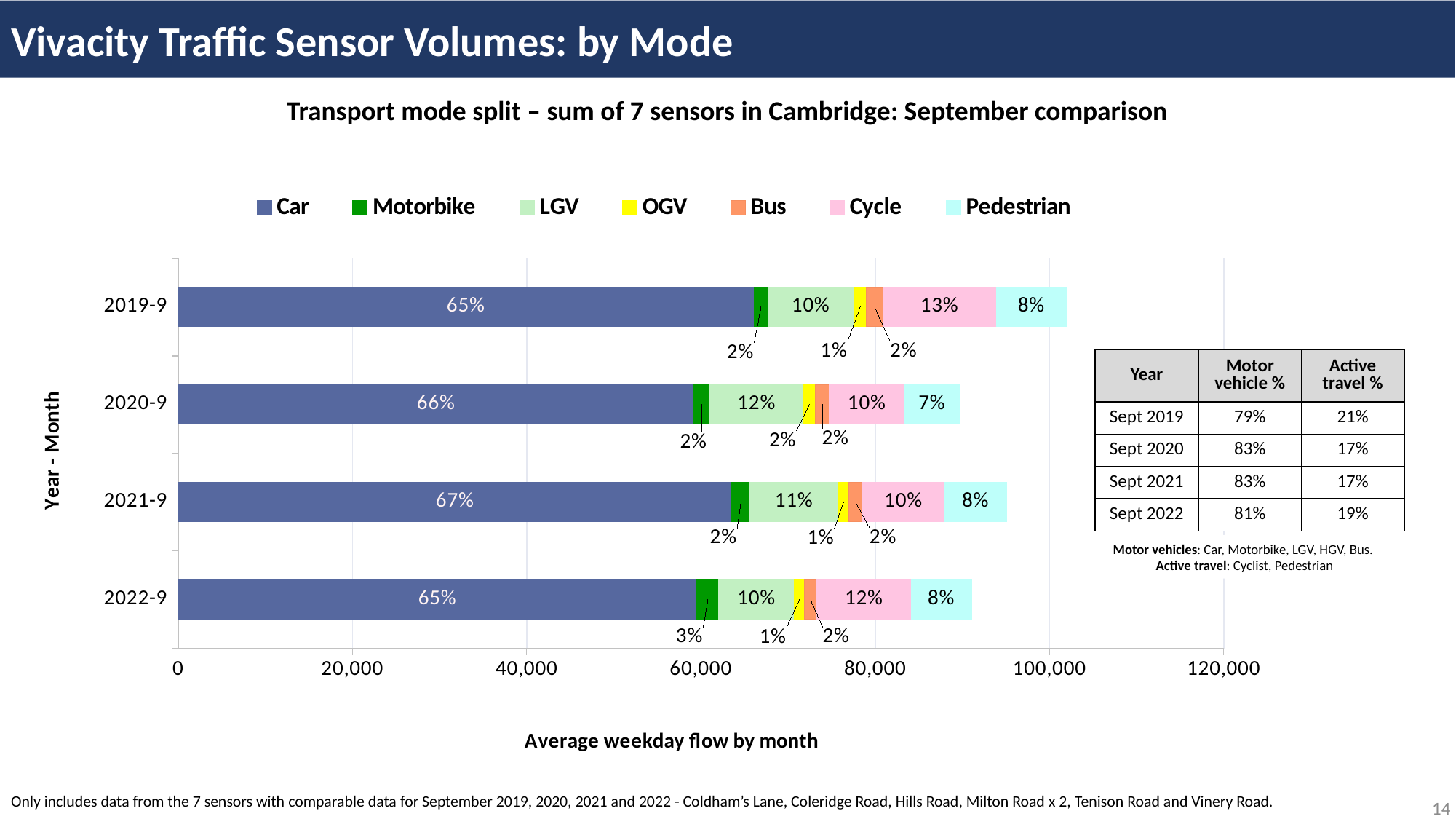
What is the Pedestrian share shown for 2020-9? 7% What type of chart is shown on the slide? Stacked bar chart Which year-month has the highest Car percentage? 2021-9 Which year-month has the lowest Pedestrian percentage? 2020-9 By how many percentage points does the Cycle share in 2019-9 exceed the Cycle share in 2022-9? 1 percentage point How many series does the legend list? 7 What is the Cycle share shown for 2019-9? 13% Which has the larger LGV share, 2019-9 or 2020-9? 2020-9 What is the Motorbike share shown for 2022-9? 3% How many year-month categories are plotted on the chart? 4 Is the total flow for the 2020-9 bar greater or less than 100,000? less What percentage share does Car have in the 2021-9 bar? 67%